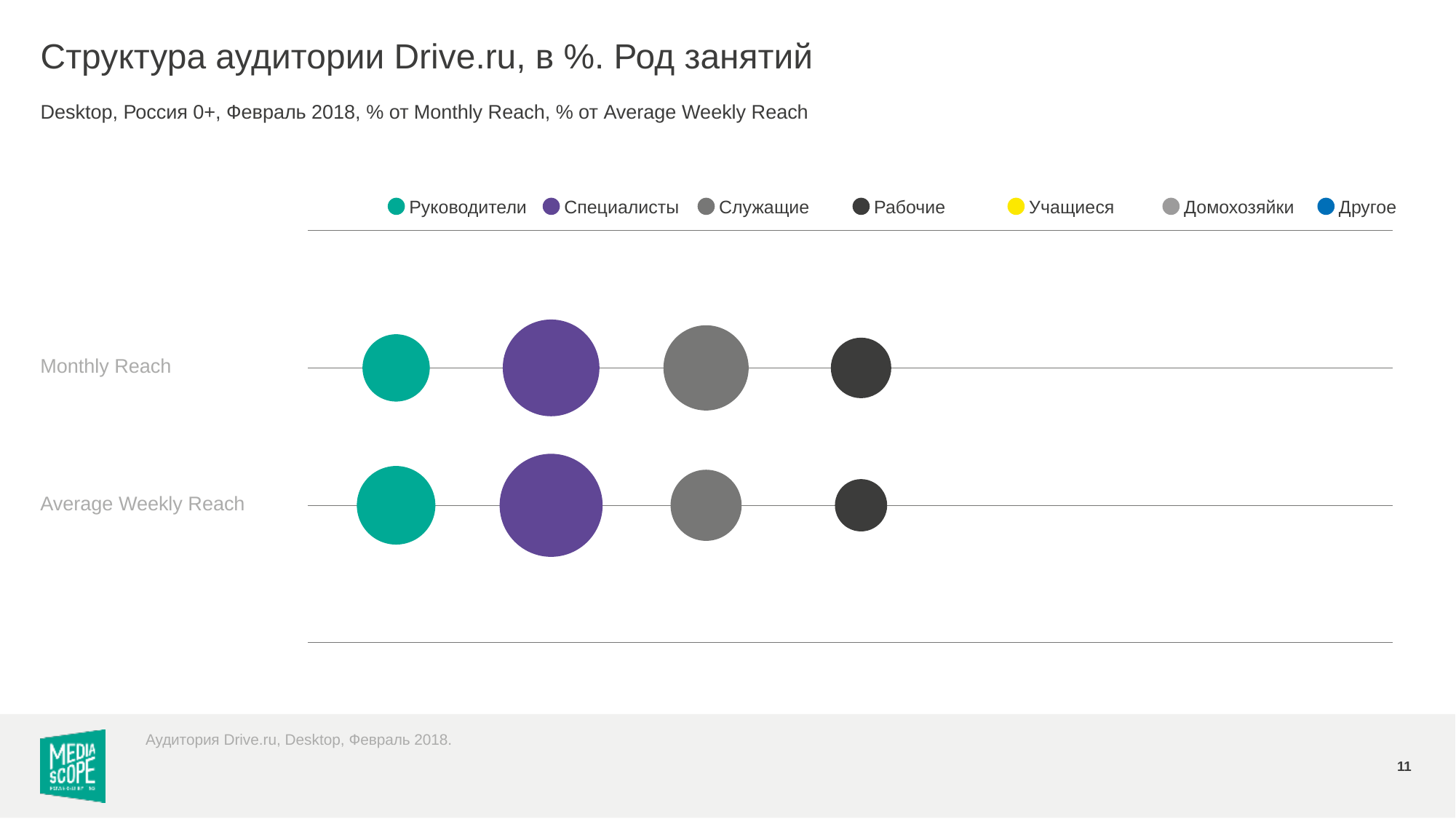
In the Average Weekly Reach row, which bubble is larger: Руководители or Рабочие? Руководители For Служащие, which row has the larger bubble: Monthly Reach or Average Weekly Reach? Monthly Reach Which occupation group has the largest bubble in the Monthly Reach row? Специалисты How many rows (categories) are plotted on the chart? 2 What is the title of the slide's chart? Структура аудитории Drive.ru, в %. Род занятий In the Monthly Reach row, which bubble is larger: Специалисты or Служащие? Специалисты Which occupation group has the largest bubble in the Average Weekly Reach row? Специалисты Which occupation group has the smallest visible bubble in the Average Weekly Reach row? Рабочие How many occupation groups have visible bubbles in the Monthly Reach row? 4 How many series does the legend list? 7 What kind of chart is shown on the slide? Bubble chart What are the two row labels on the chart? Monthly Reach, Average Weekly Reach